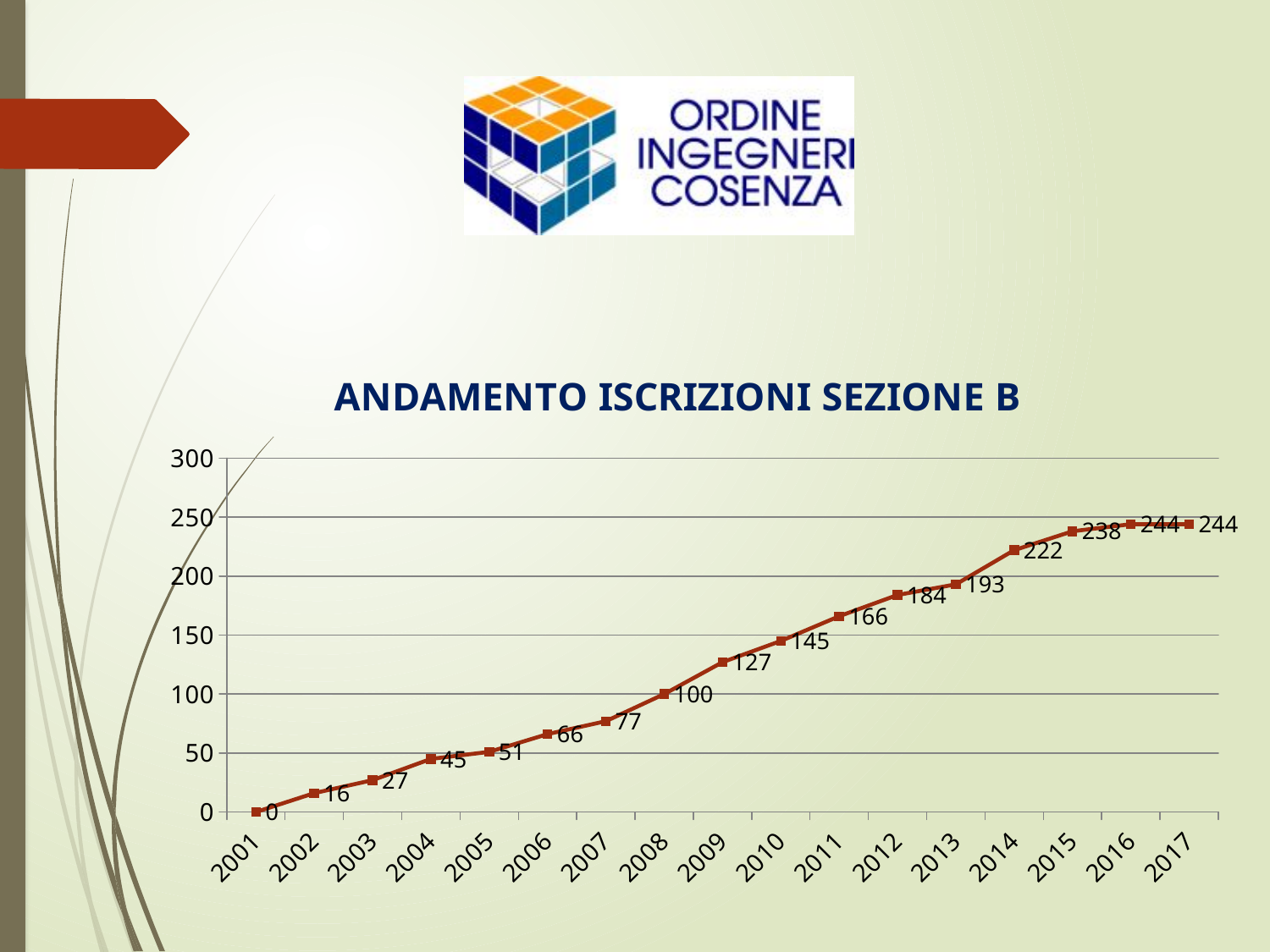
What is the value for 2008? 100 What is the highest value shown on the chart? 244 What type of chart is shown on the slide? line chart What is the value for 2014? 222 Do the values generally rise or fall from 2001 to 2017? rise How many years are plotted on the x axis? 17 What is the value for 2003? 27 Is the value for 2012 greater or less than 150? greater Which year has the lowest value? 2001 What is the title of the chart? ANDAMENTO ISCRIZIONI SEZIONE B What is the difference between the values for 2017 and 2009? 117 Which is larger, the value for 2011 or the value for 2013? 2013